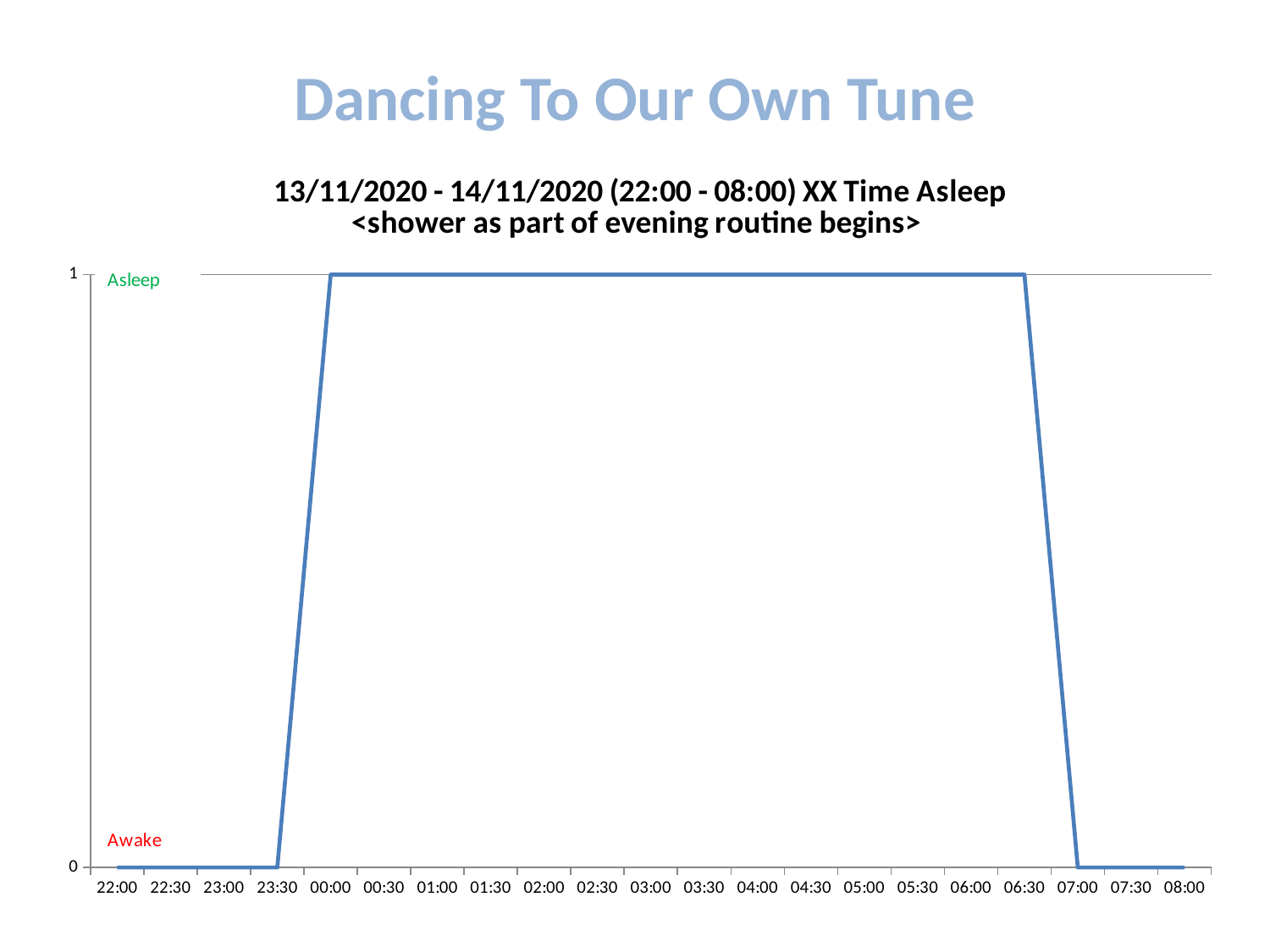
What is the value at 08:00? 0 What type of chart is shown on the slide? line chart What is the value at 00:00? 1 What is the value at 03:00? 1 How many time points are labelled on the x axis? 21 What is the value at 23:30? 0 What is the value at 07:00? 0 Which is larger, the value at 23:30 or the value at 00:00? 00:00 What is the chart's title? 13/11/2020 - 14/11/2020 (22:00 - 08:00) XX Time Asleep <shower as part of evening routine begins> What is the value at 06:30? 1 Does the line rise or fall between 06:30 and 07:00? fall What is the value at 22:00? 0